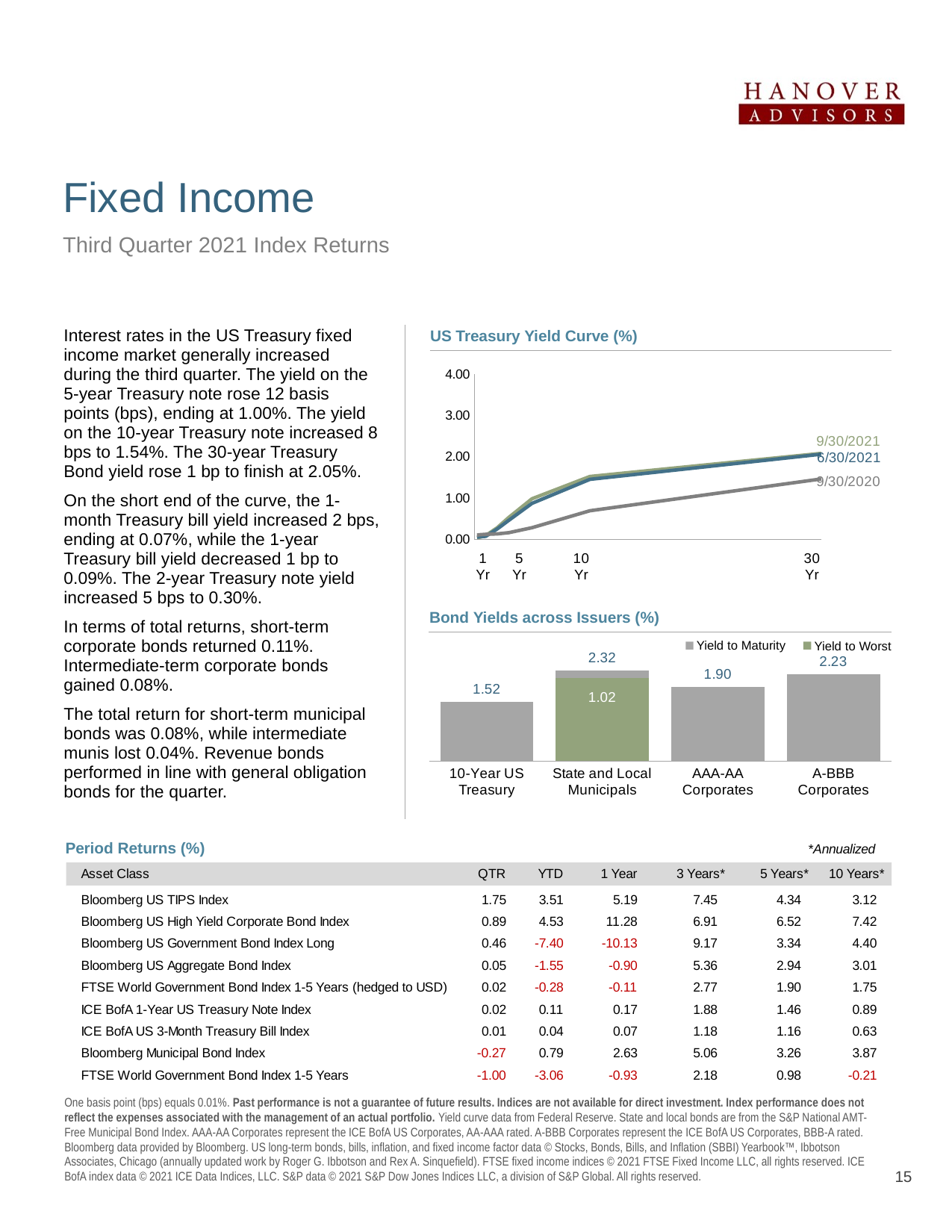
In the Bond Yields across Issuers (%) chart, which is larger, AAA-AA Corporates or 10-Year US Treasury? AAA-AA Corporates In the Bond Yields across Issuers (%) chart, what is the difference between A-BBB Corporates and AAA-AA Corporates? 0.33 What kind of chart is the US Treasury Yield Curve (%) chart? Line chart In the Bond Yields across Issuers (%) chart, what is the value for 10-Year US Treasury? 1.52 In the Bond Yields across Issuers (%) chart, what is the value for A-BBB Corporates? 2.23 In the US Treasury Yield Curve (%) chart, do the yields rise or fall as maturity increases from 1 Yr to 30 Yr? Rise In the US Treasury Yield Curve (%) chart, is the 9/30/2020 value at 30 Yr greater or less than 2.00? less In the Bond Yields across Issuers (%) chart, which category has the highest value? State and Local Municipals How many series does the US Treasury Yield Curve (%) chart show? 3 In the Bond Yields across Issuers (%) chart, what is the value for AAA-AA Corporates? 1.90 In the Bond Yields across Issuers (%) chart, how many categories are shown? 4